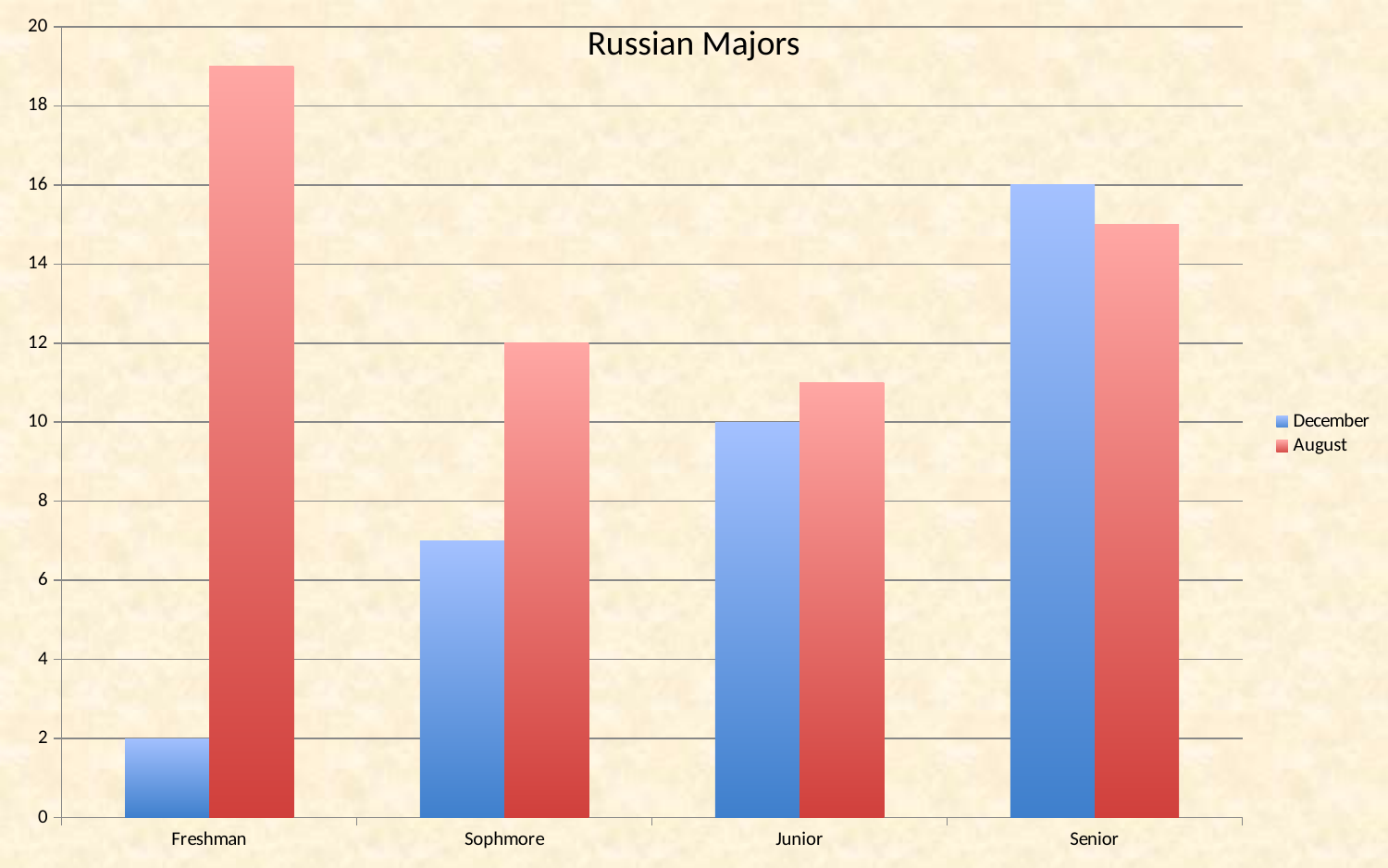
For Freshman, which is larger, the December value or the August value? August How many series does the legend list? 2 Which category has the highest August value? Freshman What is the December value for Junior? 10 What is the December value for Senior? 16 What is the August value for Sophmore? 12 How many categories are shown on the x axis? 4 Which category has the lowest December value? Freshman What is the December value for Freshman? 2 Is the December value for Sophmore greater or less than 8? less What is the difference between the December values for Senior and Freshman? 14 Is the August value for Freshman greater or less than 18? greater